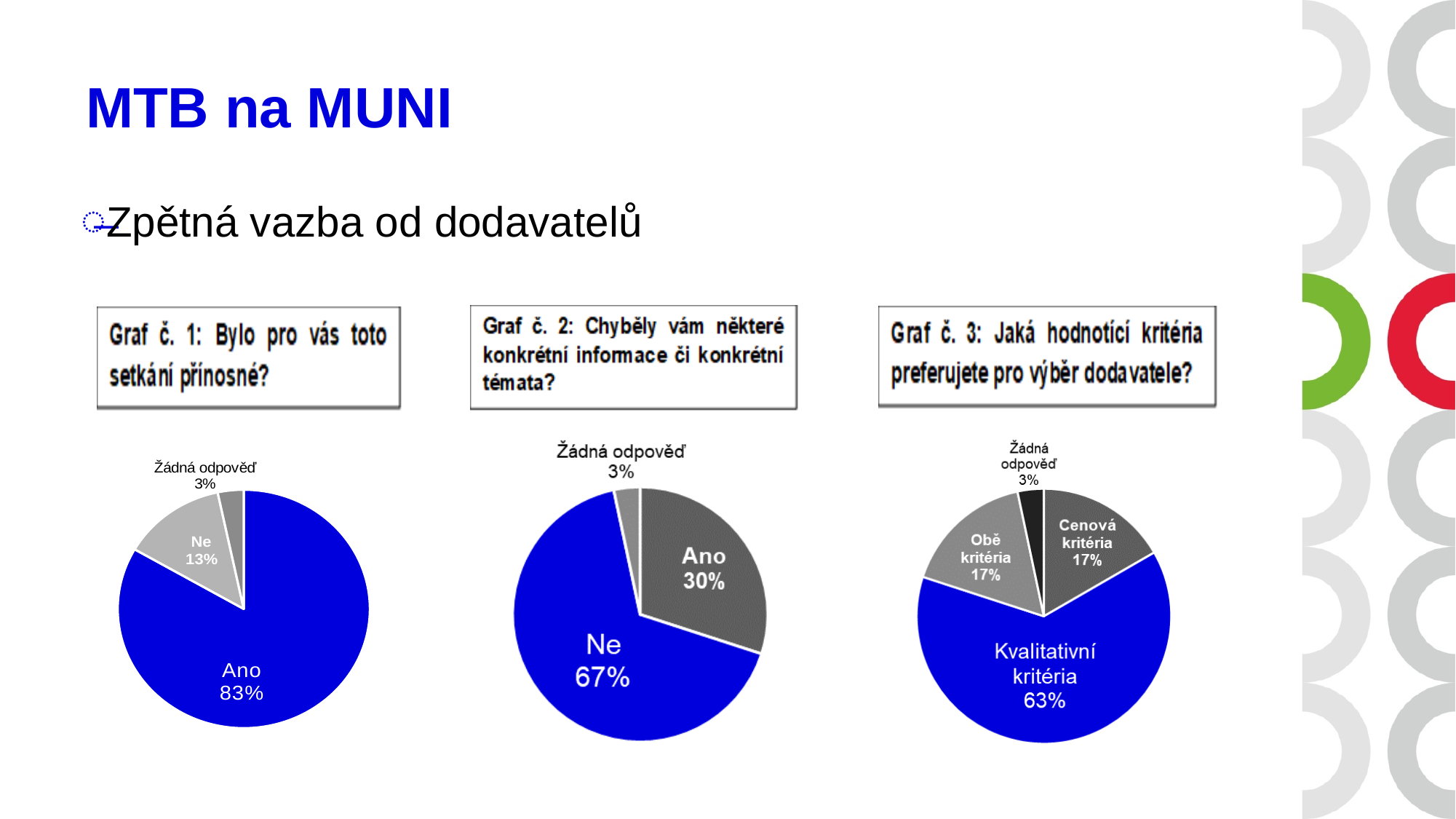
What kind of chart is Graf č. 1? Pie chart In Graf č. 1, which category has the smallest slice? Žádná odpověď In Graf č. 2, what share of respondents answered "Ne"? 67% In Graf č. 1, which is larger, the "Ano" slice or the "Ne" slice? Ano In Graf č. 1, what share of respondents answered "Ne"? 13% In Graf č. 3, how many slices does the pie chart have? 4 In Graf č. 2, what share of respondents answered "Ano"? 30% In Graf č. 2, what is the difference between the "Ne" and "Ano" shares? 37% In Graf č. 2, which category has the largest slice? Ne